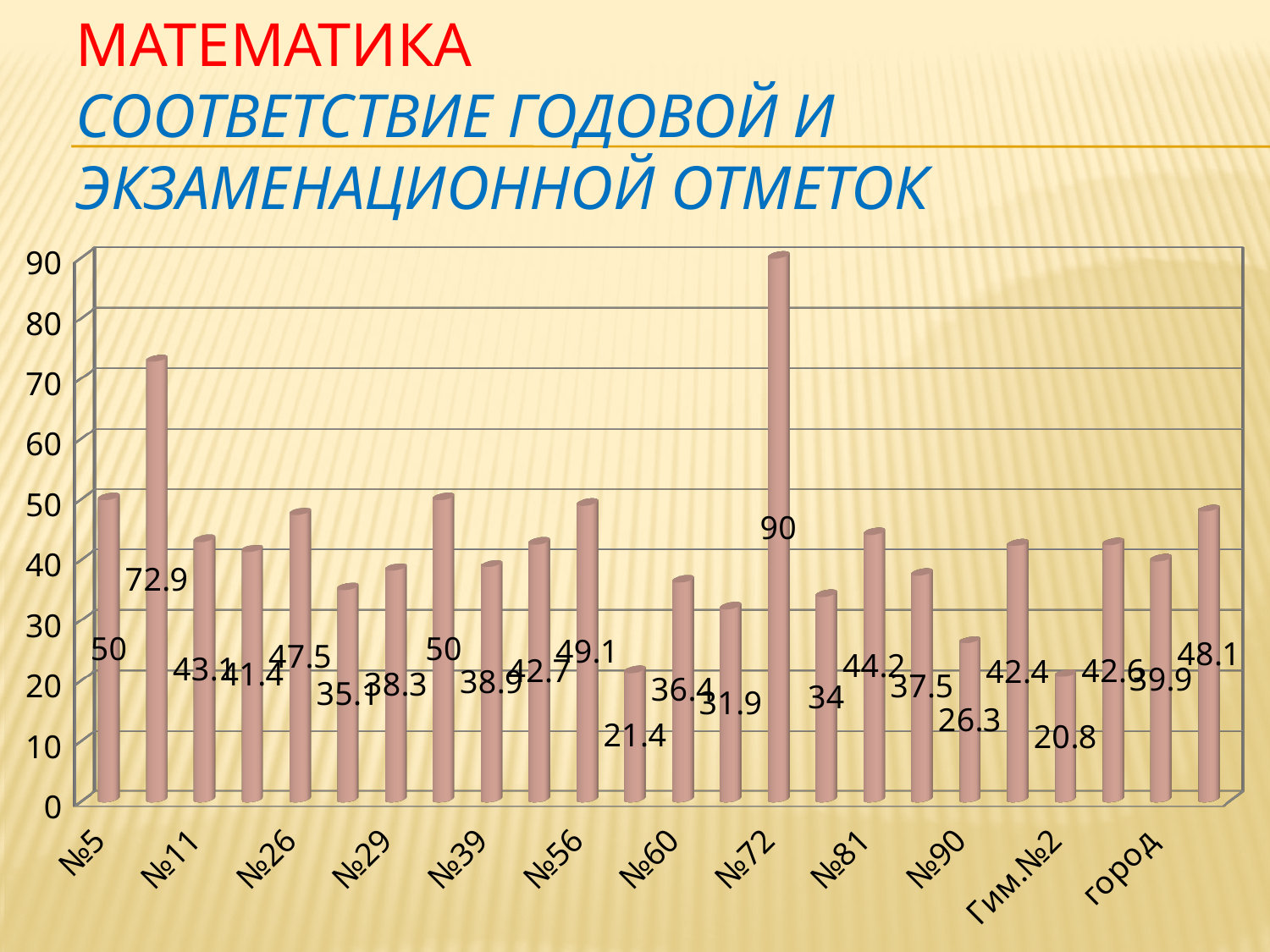
What subject is named in red at the top of the slide? МАТЕМАТИКА What type of chart is shown on the slide? bar chart What is the maximum value shown on the vertical axis? 90 What is the difference between the highest value (90) and the lowest value (20.8) in the chart? 69.2 What is the value of the first bar, for №5? 50 How many bars are plotted in the chart? 24 Is the value for №5 greater or less than 60? less What is the lowest value shown in the chart? 20.8 Which is larger: the value 72.9 or the value 49.1 shown in the chart? 72.9 What is the highest value shown in the chart? 90 Is the tallest bar in the chart greater or less than 80? greater